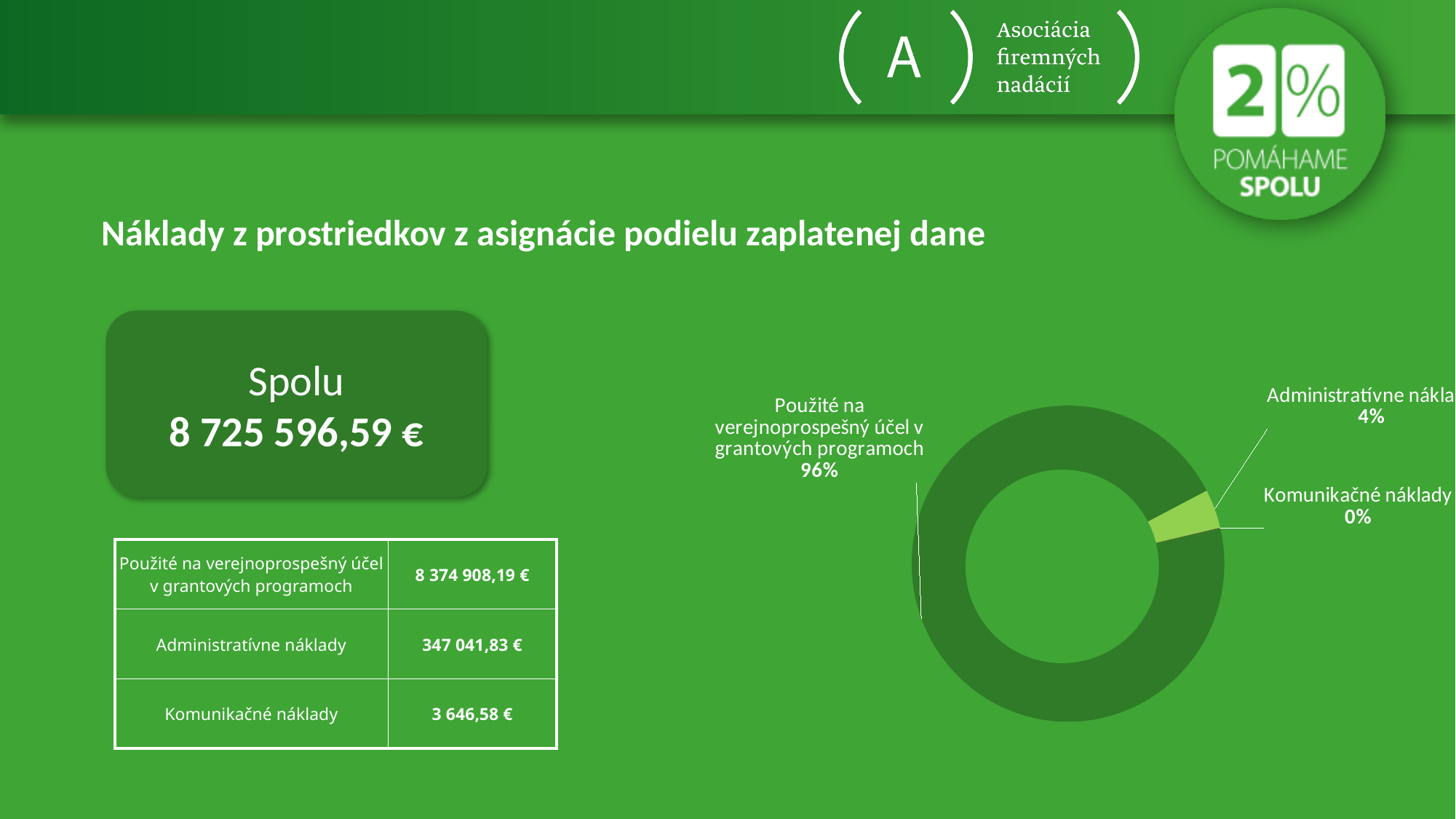
Is the share for 'Použité na verejnoprospešný účel v grantových programoch' greater or less than 50%? greater How many slices does the doughnut chart have? 3 Which category has the smallest slice in the doughnut chart? Komunikačné náklady What colour is the 'Administratívne náklady' slice in the doughnut chart? light green What kind of chart is shown on the slide? doughnut chart What share of the doughnut chart is labelled for 'Administratívne náklady'? 4% What is the title of the slide containing the doughnut chart? Náklady z prostriedkov z asignácie podielu zaplatenej dane What share of the doughnut chart is labelled for 'Použité na verejnoprospešný účel v grantových programoch'? 96% What share of the doughnut chart is labelled for 'Komunikačné náklady'? 0% What is the difference in percentage points between the 'Použité na verejnoprospešný účel v grantových programoch' slice and the 'Administratívne náklady' slice? 92 percentage points In the doughnut chart, which is larger: the share for 'Administratívne náklady' or the share for 'Komunikačné náklady'? Administratívne náklady Which category has the largest slice in the doughnut chart? Použité na verejnoprospešný účel v grantových programoch